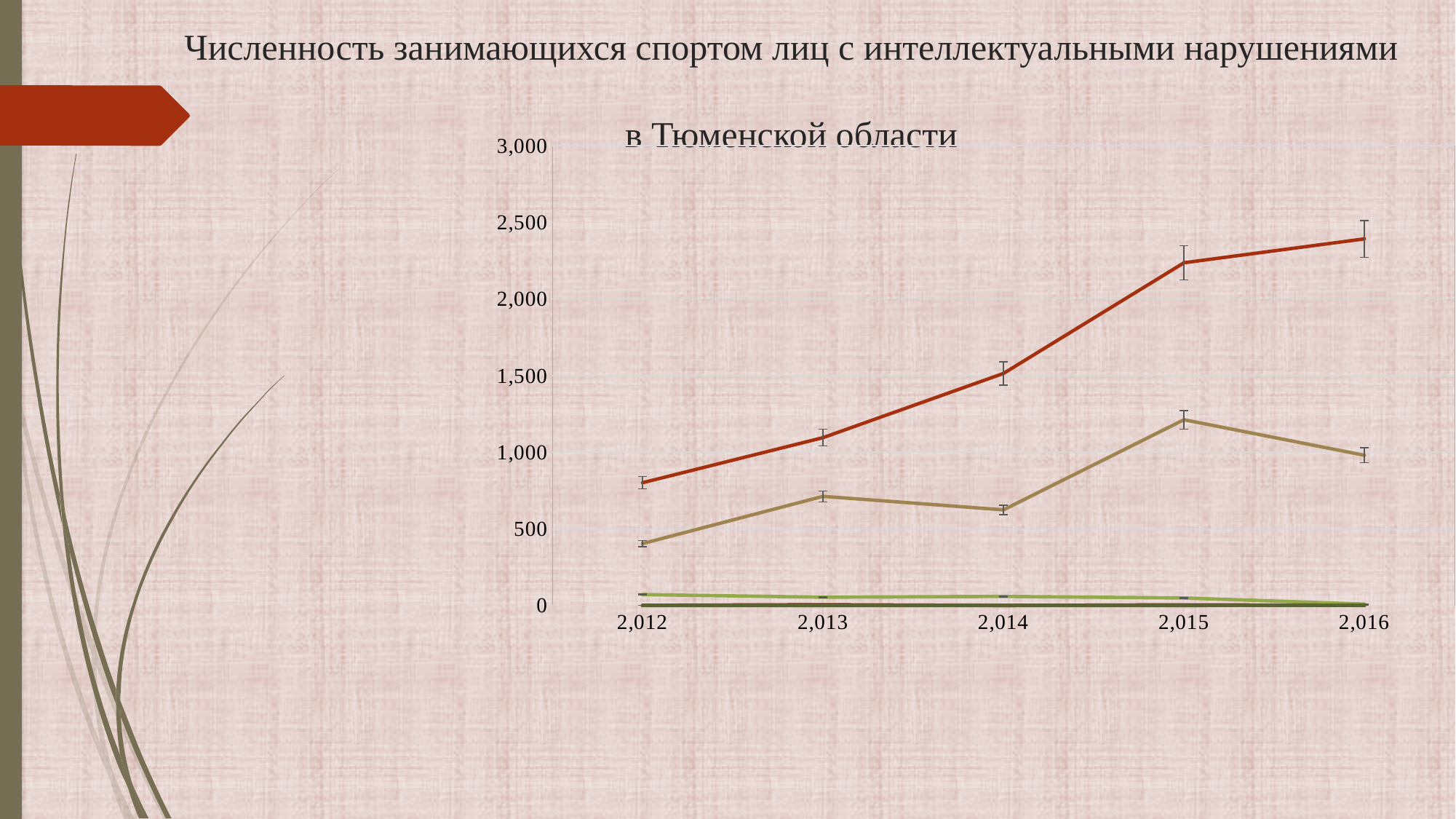
Is the value of the tan (brown) line in 2,012 greater or less than 500? less What is the title of the chart on the slide? Численность занимающихся спортом лиц с интеллектуальными нарушениями в Тюменской области How many years are shown along the x axis of the chart? 5 Is the value of the red line in 2,012 greater or less than 1,000? less In which year does the tan (brown) line reach its highest value? 2,015 In 2,016, which line has the larger value, the red line or the tan (brown) line? the red line In which year does the red line reach its highest value? 2,016 Does the red line rise or fall from 2,012 to 2,016? rises Is the value of the tan (brown) line in 2,015 greater or less than 1,000? greater In which year is the red line at its lowest value? 2,012 What kind of chart is shown on the slide? line chart